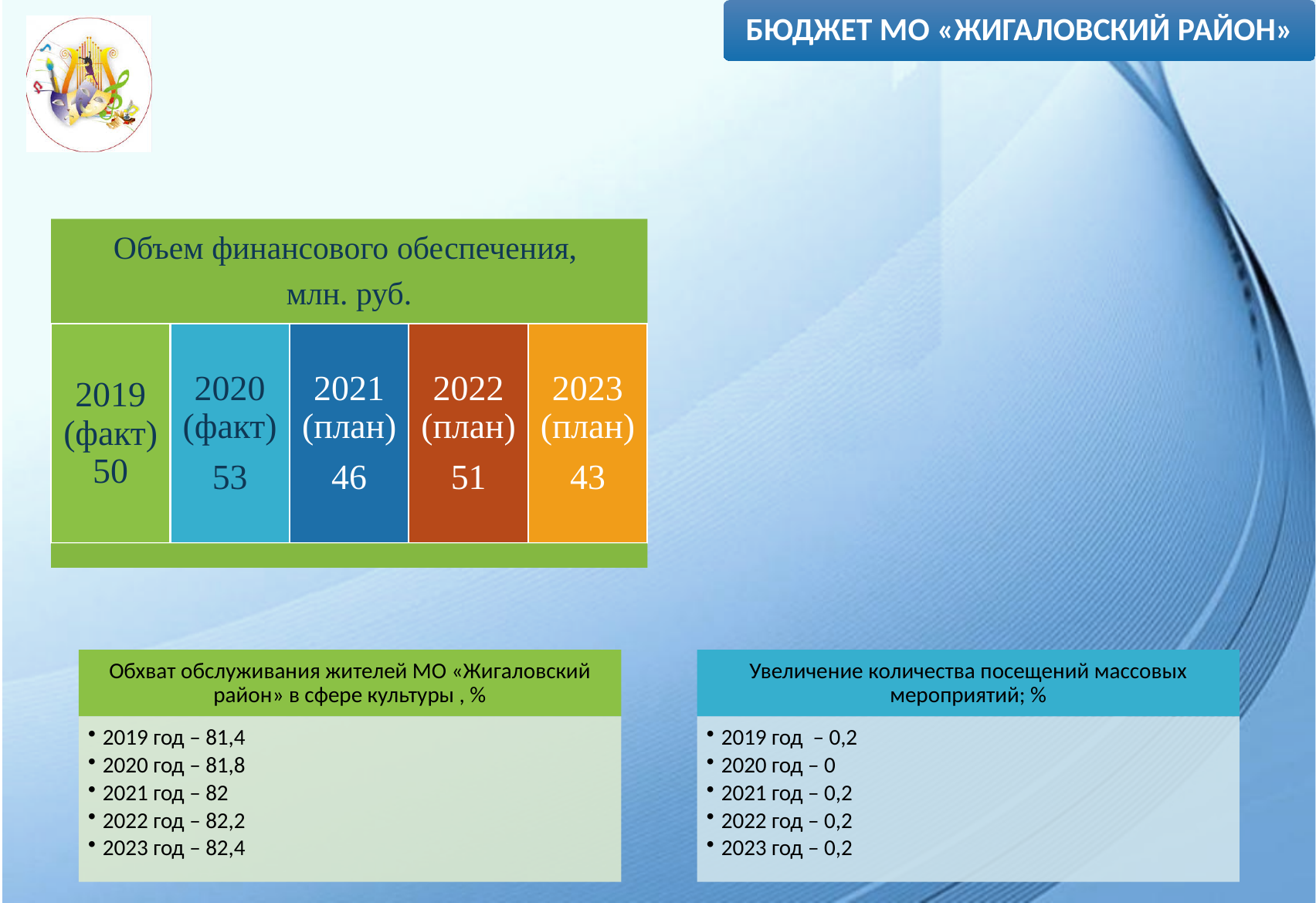
In the chart 'Объем финансового обеспечения, млн. руб.', what colour is the column for 2022 (план)? Brown (dark orange-red) In the chart 'Объем финансового обеспечения, млн. руб.', which year has the lowest value? 2023 (план) In the chart 'Объем финансового обеспечения, млн. руб.', what is the difference between the values for 2020 (факт) and 2021 (план)? 7 In the chart 'Объем финансового обеспечения, млн. руб.', which year has the highest value? 2020 (факт) In the chart 'Объем финансового обеспечения, млн. руб.', what is the value for 2023 (план)? 43 In the chart 'Объем финансового обеспечения, млн. руб.', what is the value for 2019 (факт)? 50 In the chart 'Объем финансового обеспечения, млн. руб.', what is the difference between the values for 2022 (план) and 2023 (план)? 8 In the chart 'Объем финансового обеспечения, млн. руб.', how many years are marked as 'план'? 3 What unit is given in the title of the chart 'Объем финансового обеспечения'? млн. руб. In the chart 'Объем финансового обеспечения, млн. руб.', what is the value for 2020 (факт)? 53 In the chart 'Объем финансового обеспечения, млн. руб.', which is larger: the value for 2019 (факт) or 2022 (план)? 2022 (план) How many years are shown in the chart 'Объем финансового обеспечения, млн. руб.'? 5